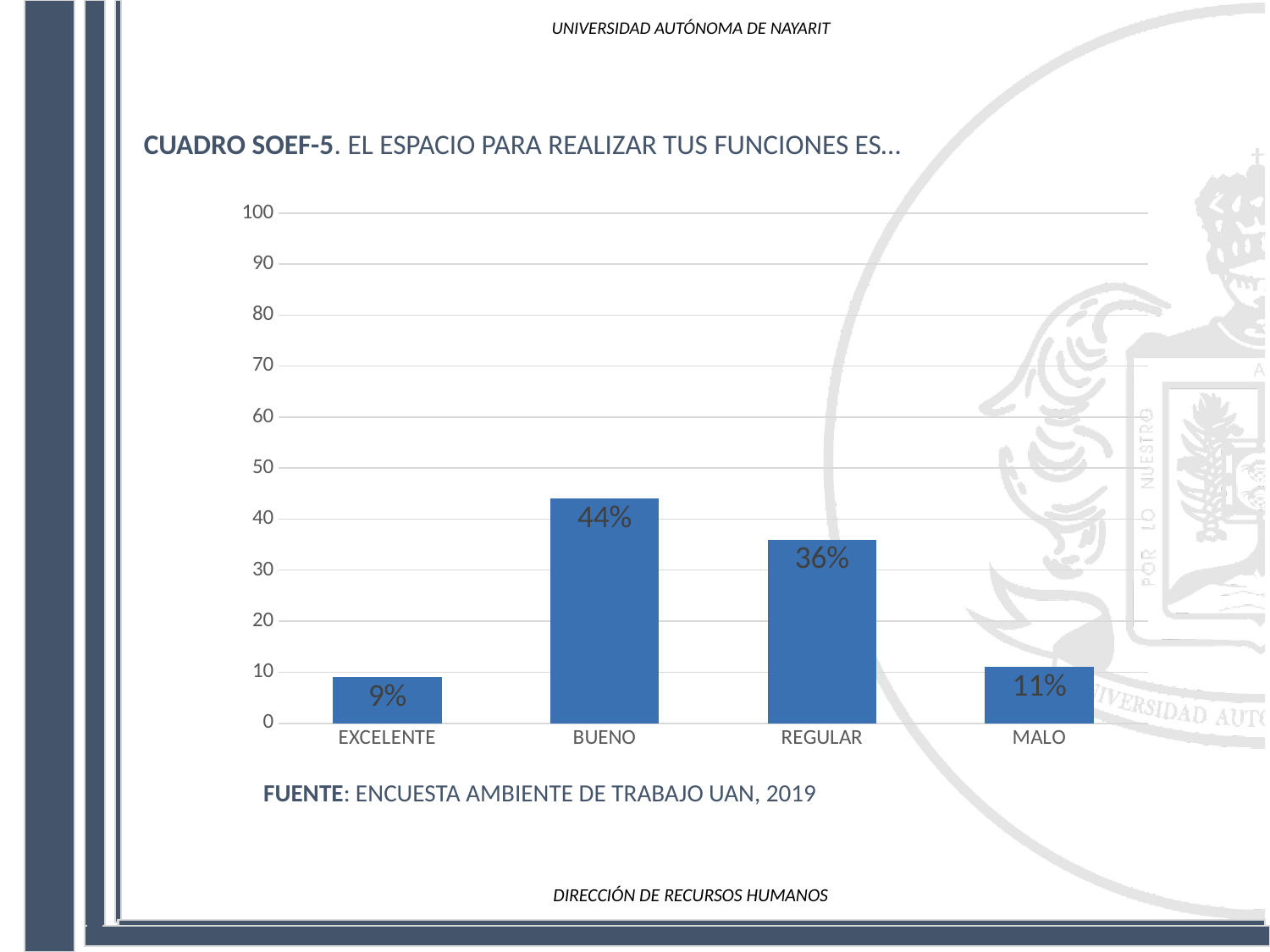
Which category has the lowest value? EXCELENTE What is the difference between the values for BUENO and REGULAR? 8% How many categories are shown on the x axis? 4 What is the value for BUENO? 44% What is the value for EXCELENTE? 9% Is the value for REGULAR greater or less than 40? less Which is larger, the value for MALO or the value for EXCELENTE? MALO What is the value for REGULAR? 36% Which category has the highest value? BUENO What is the value for MALO? 11% What source is cited below the chart? ENCUESTA AMBIENTE DE TRABAJO UAN, 2019 What kind of chart is shown on the slide? bar chart